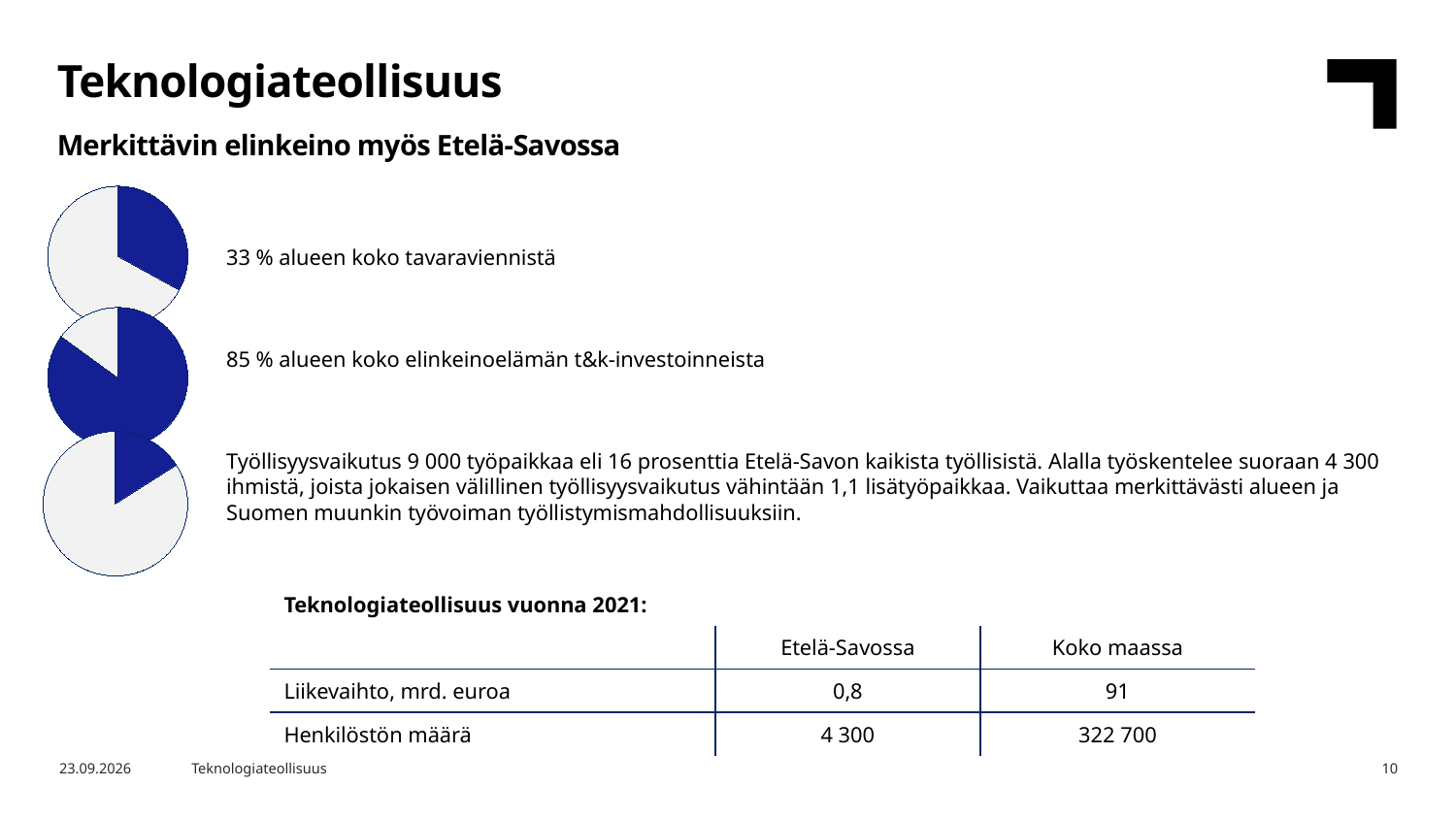
Is the blue slice in the top pie chart greater or less than 50%? less Which of the three pie charts has the largest blue slice? The middle pie chart (85 %) What kind of charts are shown on the left side of the slide? Pie charts How many slices does the top pie chart have? 2 What two colours are used for the slices in the pie charts? Blue and light grey How many pie charts are on the slide? 3 According to the text next to the top pie chart, what share of the region's total goods exports does the technology industry account for? 33 % According to the text next to the middle pie chart, what share of the region's business R&D investments does the technology industry account for? 85 % Which is larger: the blue slice in the top pie chart or the blue slice in the bottom pie chart? The top pie chart Is the blue slice in the middle pie chart greater or less than 50%? greater According to the text next to the bottom pie chart, what percentage of all employed people in Etelä-Savo does the employment effect represent? 16 prosenttia Which of the three pie charts has the smallest blue slice? The bottom pie chart (16 prosenttia)